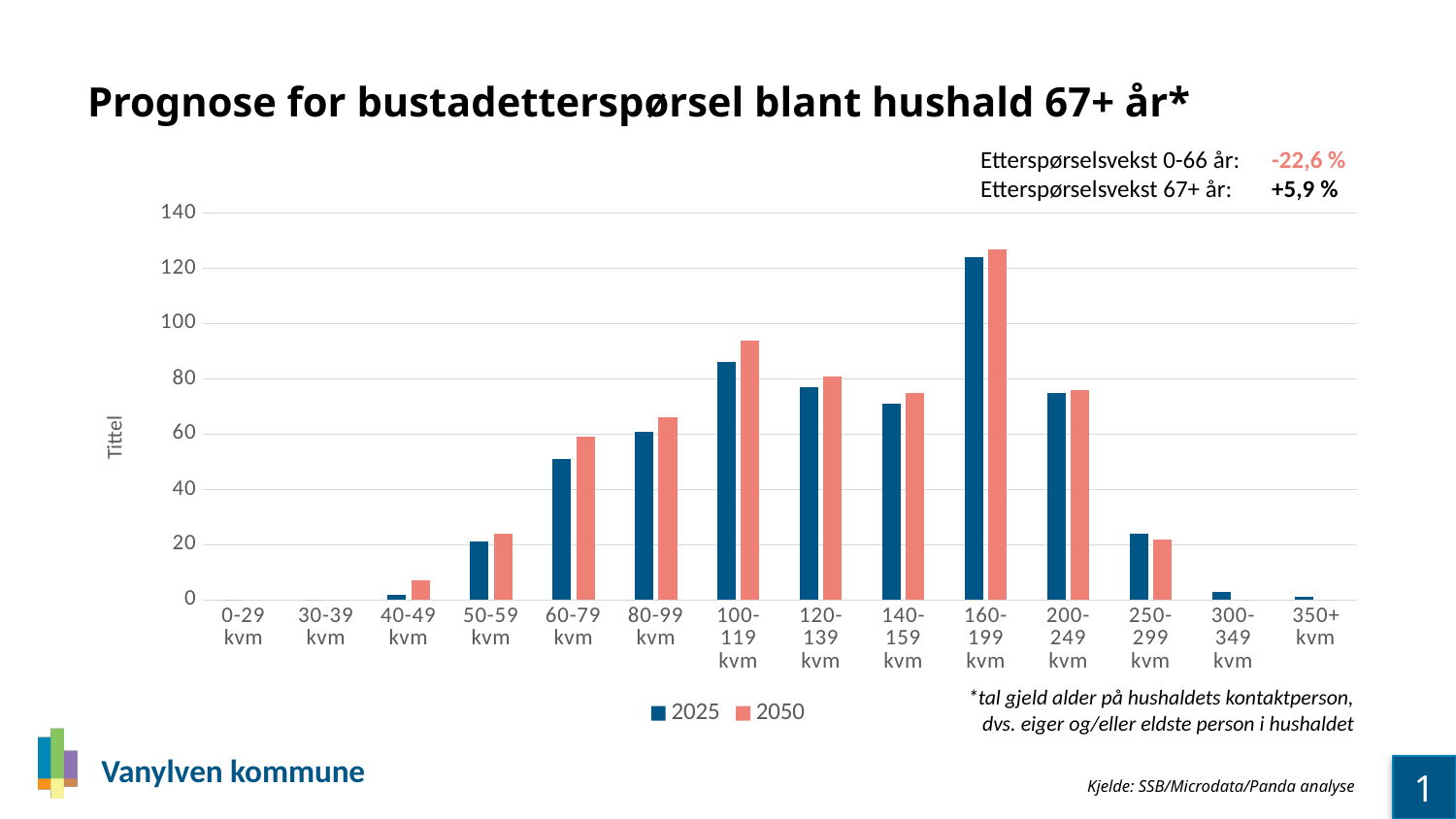
Is the 2050 value for 60-79 kvm greater or less than 40? greater What are the two series named in the chart's legend? 2025 and 2050 For the 100-119 kvm category, which series has the larger value, 2025 or 2050? 2050 Is the 2050 value for 100-119 kvm greater or less than 100? less Which category has the highest value for the 2050 series? 160-199 kvm Is the 2025 value for 250-299 kvm greater or less than 40? less How many series does the chart's legend list? 2 Which category has the highest value for the 2025 series? 160-199 kvm What kind of chart is shown on the slide? bar chart How many size categories are shown on the x axis of the chart? 14 What is the title of the chart on the slide? Prognose for bustadetterspørsel blant hushald 67+ år*